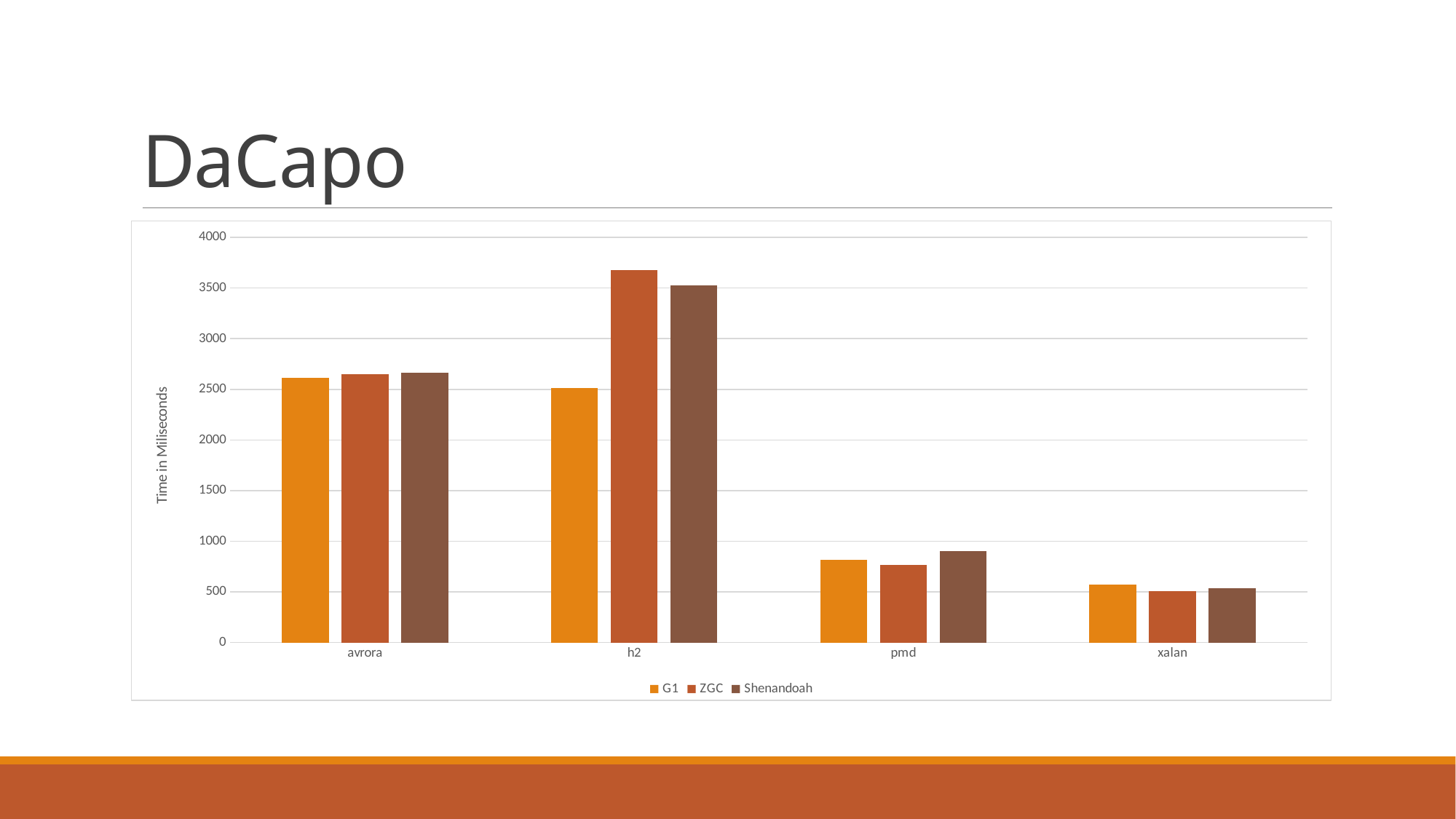
Is the G1 value for xalan greater or less than 500? greater Is the ZGC value for h2 greater or less than 3500? greater How many benchmark categories are shown on the x axis? 4 Is the Shenandoah value for pmd greater or less than 1000? less What kind of chart is shown on the slide? bar chart What is the label on the vertical axis? Time in Miliseconds Which series has the highest bar for pmd? Shenandoah Which series has the highest bar for h2? ZGC Which series has the lowest bar for h2? G1 Which is larger for pmd, the ZGC bar or the Shenandoah bar? Shenandoah How many series does the legend list? 3